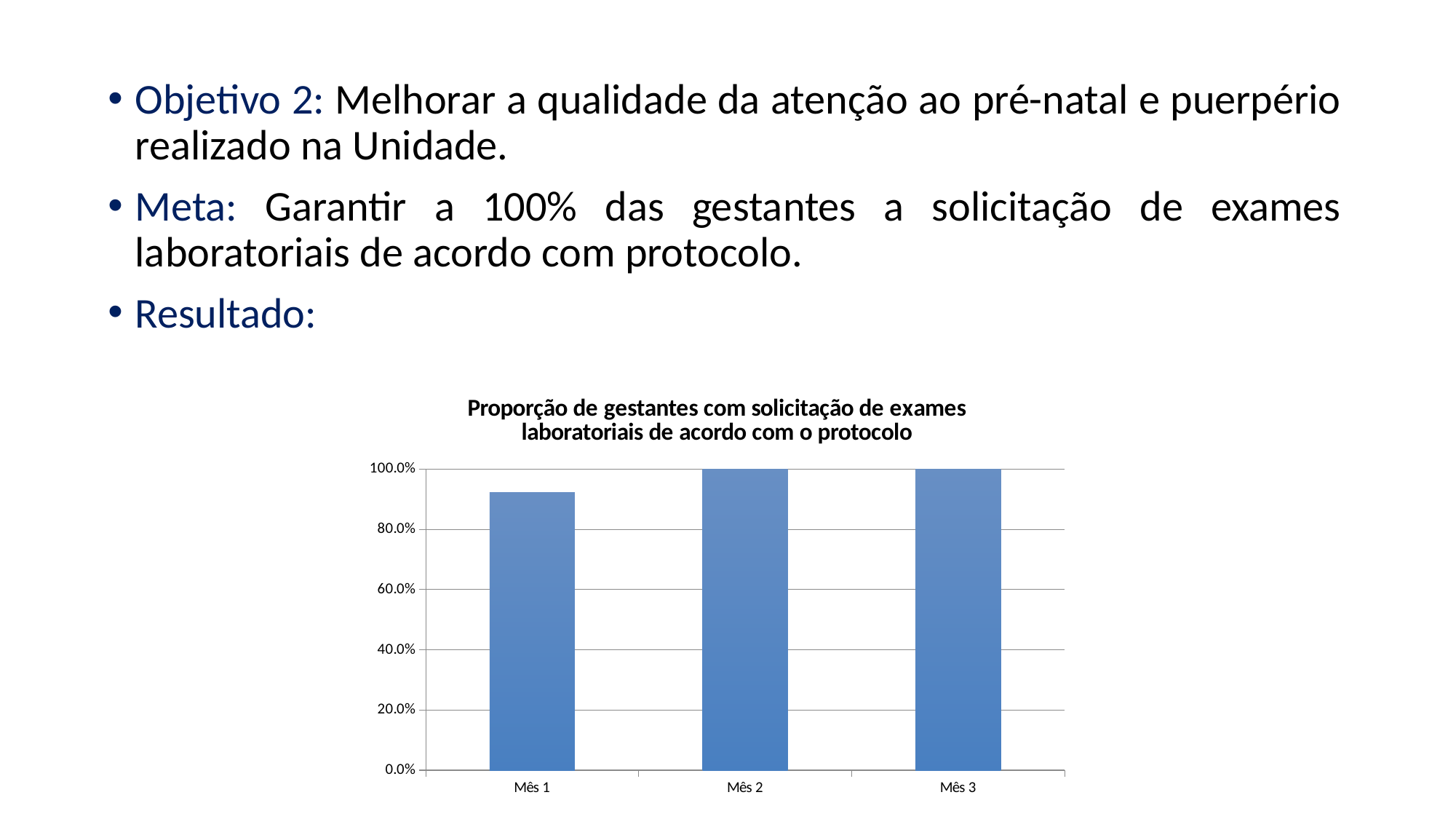
What is the value for Mês 2? 100.0% Is the value for Mês 1 greater or less than 80.0%? greater How many categories (months) are plotted in the chart? 3 What is the title of the chart? Proporção de gestantes com solicitação de exames laboratoriais de acordo com o protocolo What colour are the bars in the chart? Blue Which month has the lowest value? Mês 1 Is the value for Mês 1 greater or less than 100.0%? less Which months reach 100.0%? Mês 2 and Mês 3 What kind of chart is shown on the slide? Bar chart Do the values rise or fall from Mês 1 to Mês 2? rise What is the value for Mês 3? 100.0% Which is larger, the value for Mês 1 or the value for Mês 2? Mês 2